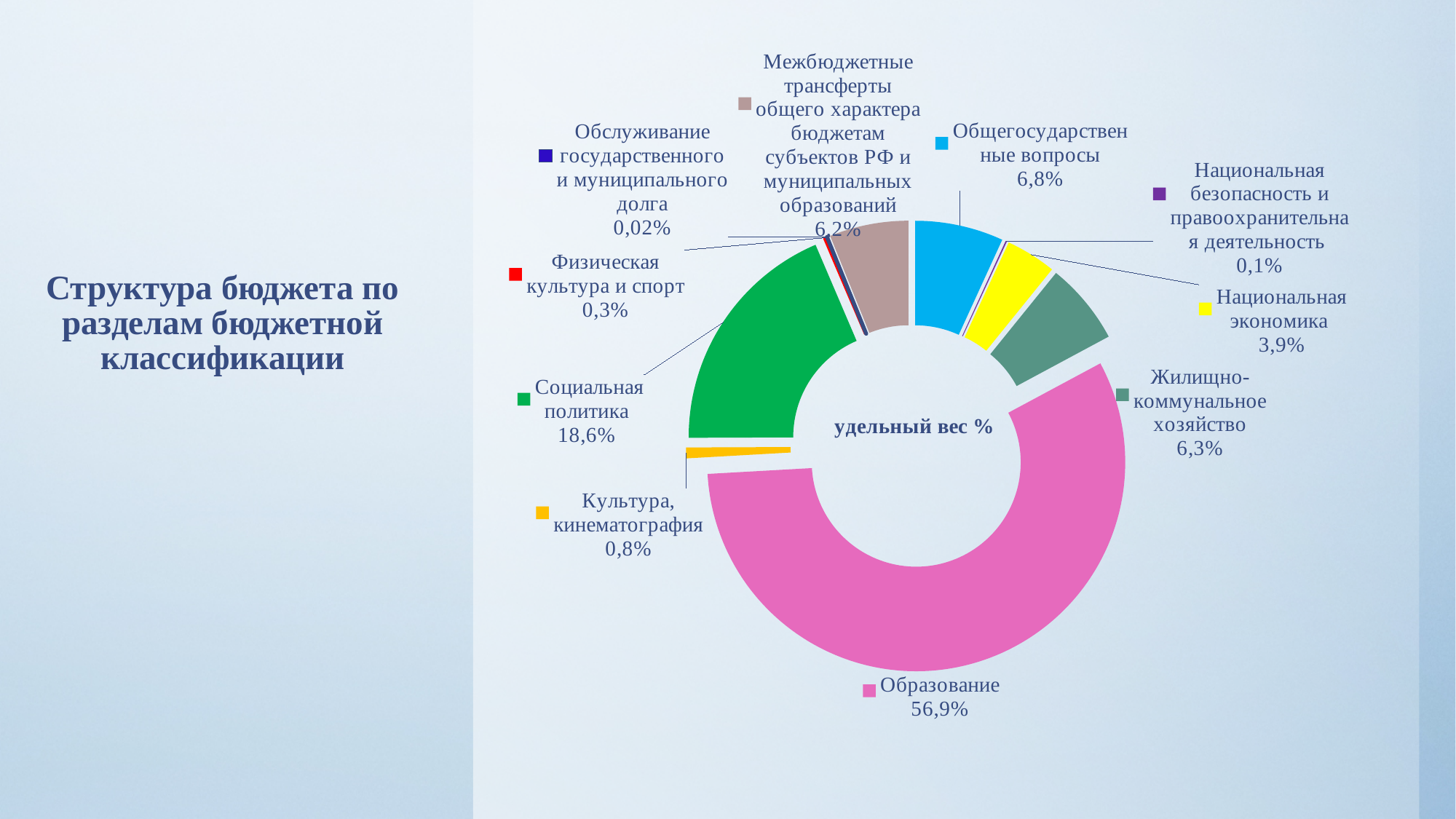
What is the value shown for Социальная политика? 18,6% What colour is the segment for Образование? Pink How many budget sections are shown in the chart? 10 Which section has the largest share of the budget? Образование What is the value for Обслуживание государственного и муниципального долга? 0,02% Which section has the smallest share of the budget? Обслуживание государственного и муниципального долга What percentage is shown for Жилищно-коммунальное хозяйство? 6,3% What kind of chart is shown on the slide? Doughnut (pie) chart What text is written in the centre of the doughnut chart? удельный вес % Which is larger: the share of Жилищно-коммунальное хозяйство or the share of Межбюджетные трансферты общего характера? Жилищно-коммунальное хозяйство What share of the budget does Образование account for? 56,9% What is the difference between the shares of Общегосударственные вопросы and Национальная экономика? 2,9%